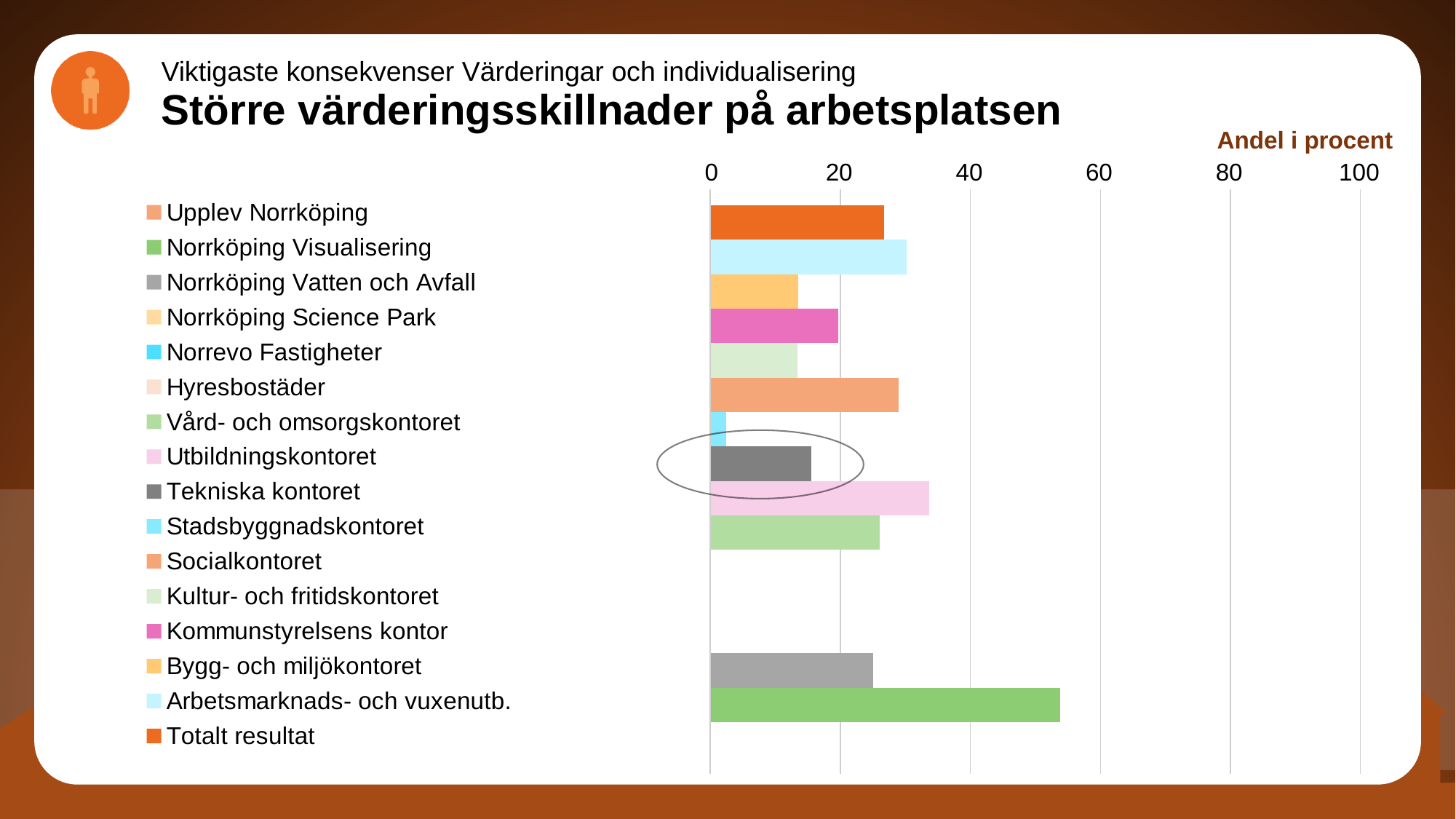
Is the value for Utbildningskontoret greater or less than 20? greater Is the value for Norrköping Visualisering greater or less than 40? greater Is the value for Totalt resultat greater or less than 20? greater Which legend entry has the longest bar? Norrköping Visualisering Which legend entry has the shortest bar? Stadsbyggnadskontoret How many entries does the legend list? 16 Which is larger, the value for Utbildningskontoret or the value for Tekniska kontoret? Utbildningskontoret What kind of chart is shown on the slide? bar chart Which is larger, the value for Norrköping Visualisering or the value for Totalt resultat? Norrköping Visualisering What label is shown above the horizontal axis of the chart? Andel i procent